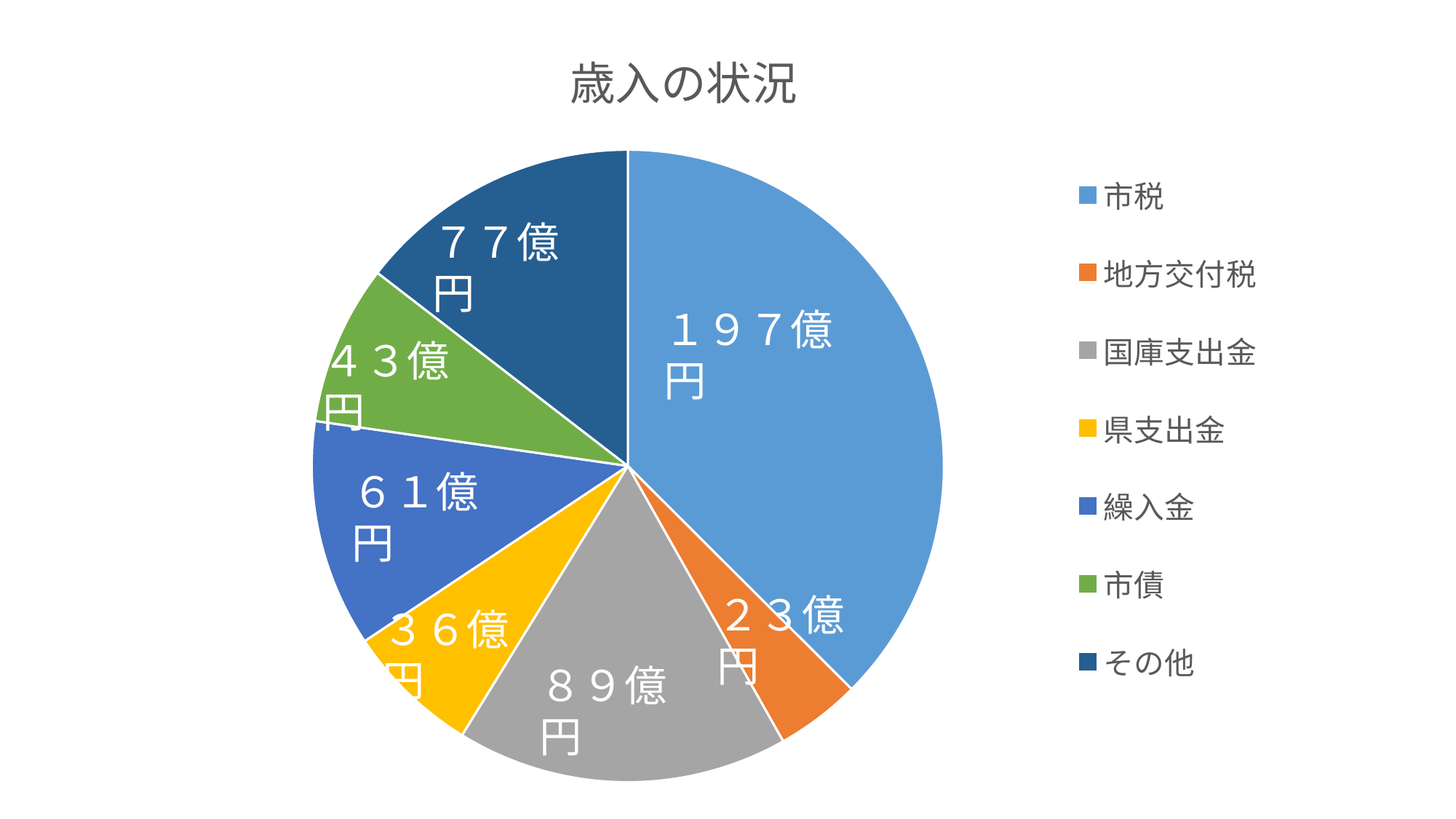
What is the value for 繰入金? ６１億円 What is the title of the chart? 歳入の状況 How many categories does the pie chart show? 7 Which category has the largest slice? 市税 What is the value for その他? ７７億円 What is the difference between 国庫支出金 and 繰入金? ２８億円 What is the difference between 市税 and 地方交付税? １７４億円 Which category has the smallest slice? 地方交付税 What is the value for 市税 in the pie chart? １９７億円 Which is larger, 県支出金 or 市債? 市債 What is the value for 国庫支出金? ８９億円 What kind of chart is shown on the slide? pie chart